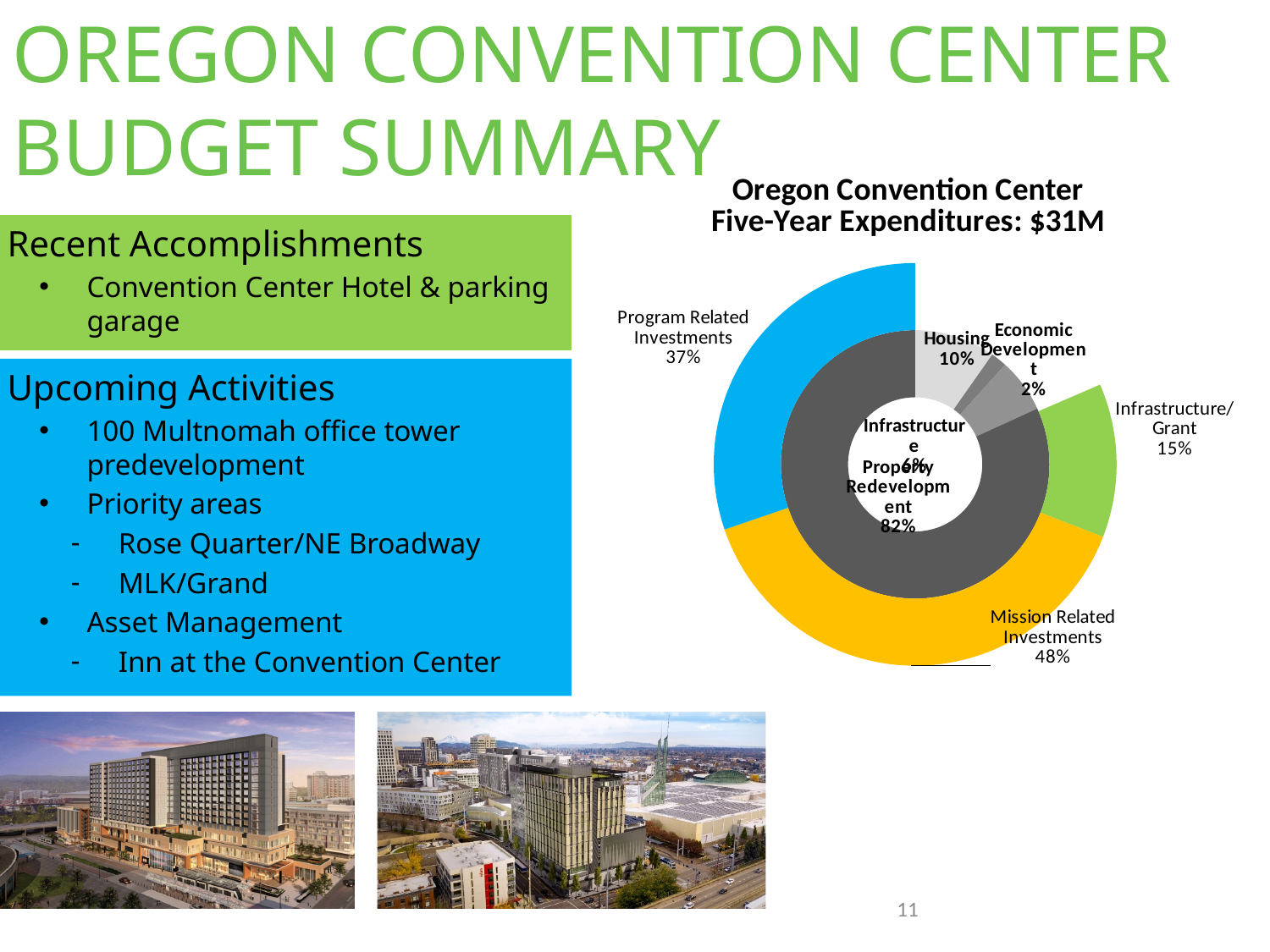
What percentage of the Oregon Convention Center five-year expenditures is Mission Related Investments? 48% What percentage does the Property Redevelopment segment show in the inner ring of the chart? 82% What percentage of the Oregon Convention Center five-year expenditures is Program Related Investments? 37% Which category in the outer ring of the chart has the largest share? Mission Related Investments What kind of chart is shown on the slide? Doughnut chart How many percentage points larger is Mission Related Investments than Program Related Investments? 11 percentage points According to the chart title, what is the total five-year expenditure for the Oregon Convention Center? $31M What percentage does the Housing segment show in the inner ring of the chart? 10% What percentage of the Oregon Convention Center five-year expenditures is Infrastructure/Grant? 15% Which category in the inner ring of the chart has the smallest share? Economic Development What percentage does the Economic Development segment show in the inner ring of the chart? 2%